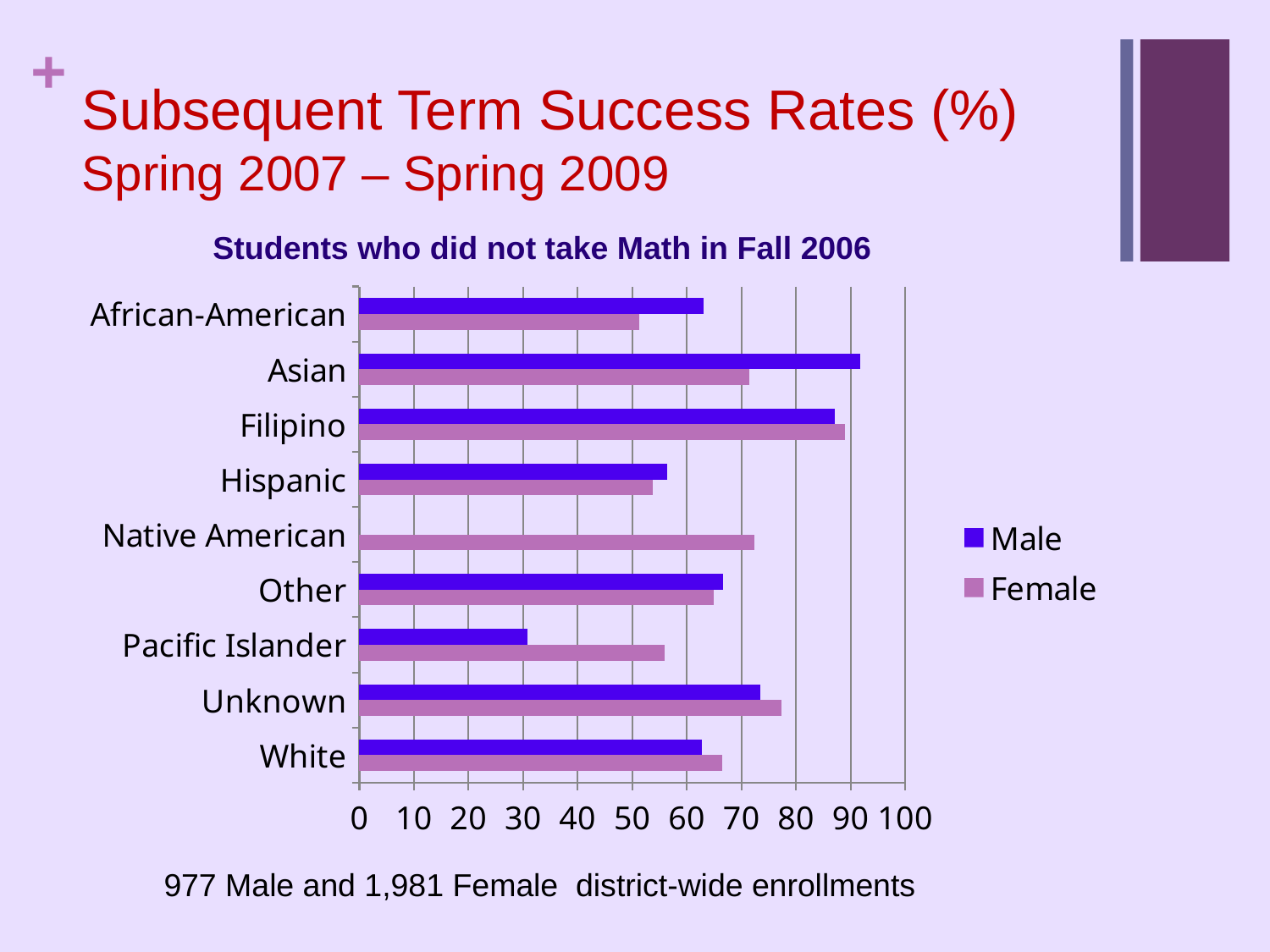
For Asian, which is larger, the Male or the Female value? Male Is the Male value for Asian greater or less than 80? greater How many series does the legend list? 2 What is the title of the chart? Students who did not take Math in Fall 2006 What kind of chart is shown on the slide? bar chart Which category has the highest Female success rate? Filipino Is the Female value for African-American greater or less than 60? less Among categories with a Male bar, which has the lowest Male success rate? Pacific Islander How many ethnic categories are shown on the chart? 9 Is the Male value for Pacific Islander greater or less than 40? less Which category has the highest Male success rate? Asian For Pacific Islander, which is larger, the Male or the Female value? Female